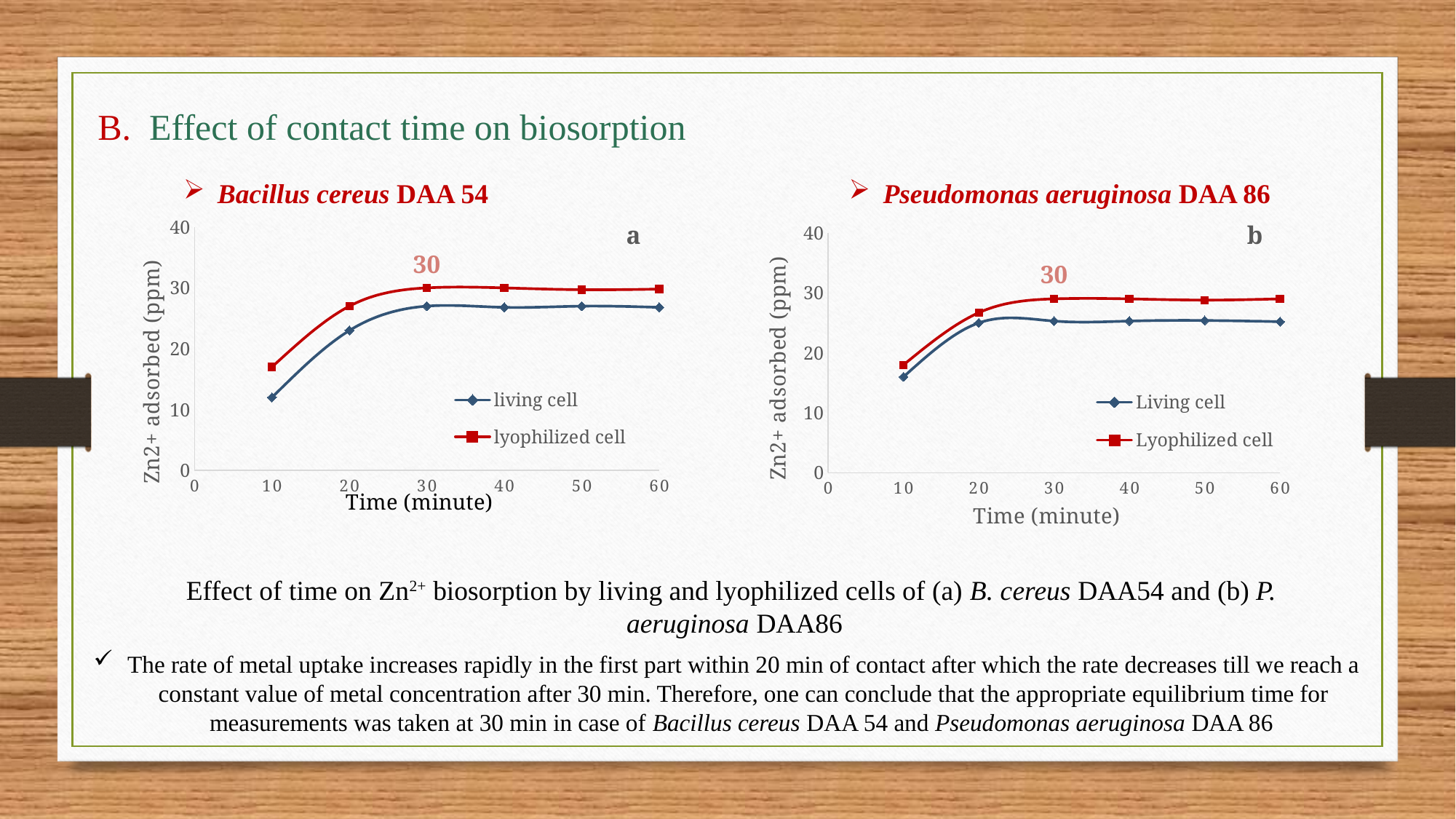
In the Bacillus cereus DAA 54 chart (a), at which time does the living cell series have its lowest value? 10 In the Pseudomonas aeruginosa DAA 86 chart (b), which series has the larger value at 30 minutes, Living cell or Lyophilized cell? Lyophilized cell In the Pseudomonas aeruginosa DAA 86 chart (b), how does the Lyophilized cell series change between 10 and 30 minutes? rises In the Pseudomonas aeruginosa DAA 86 chart (b), is the value for Living cell at 10 minutes greater or less than 20? less What is the y-axis label of the Bacillus cereus DAA 54 chart (a)? Zn2+ adsorbed (ppm) In the Bacillus cereus DAA 54 chart (a), is the value for lyophilized cell at 30 minutes greater or less than 20? greater In the Bacillus cereus DAA 54 chart (a), is the value for living cell at 10 minutes greater or less than 20? less How many series does the legend of the Pseudomonas aeruginosa DAA 86 chart (b) list? 2 In the Bacillus cereus DAA 54 chart (a), which series has the larger value at 20 minutes, living cell or lyophilized cell? lyophilized cell In the Bacillus cereus DAA 54 chart (a), how many data points are plotted for the living cell series? 6 What kind of chart is the Bacillus cereus DAA 54 chart (a)? line chart